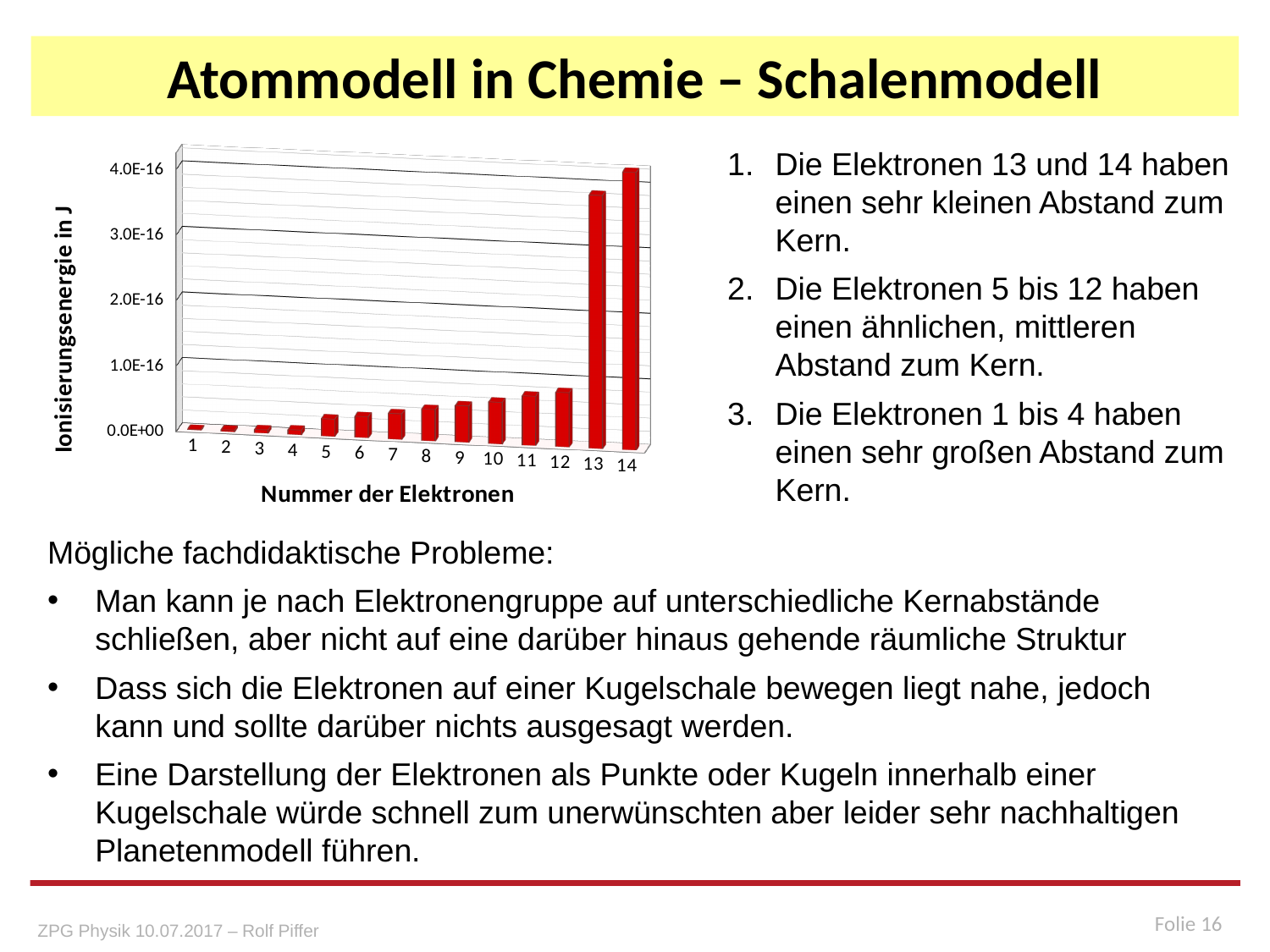
Which electron number has the highest ionisation energy in the chart? 14 Is the value for electron 5 greater or less than 1.0E-16? less Which has the larger ionisation energy, electron 13 or electron 14? 14 Do the values rise or fall as the electron number increases along the x axis? rise Which has the larger ionisation energy, electron 12 or electron 5? 12 What kind of chart is shown on the slide? bar chart What is the title of the x axis of the chart? Nummer der Elektronen Is the value for electron 13 greater or less than 3.0E-16? greater How many electrons (categories) are plotted on the x axis of the chart? 14 What is the title of the y axis of the chart? Ionisierungsenergie in J Is the value for electron 12 greater or less than 1.0E-16? less